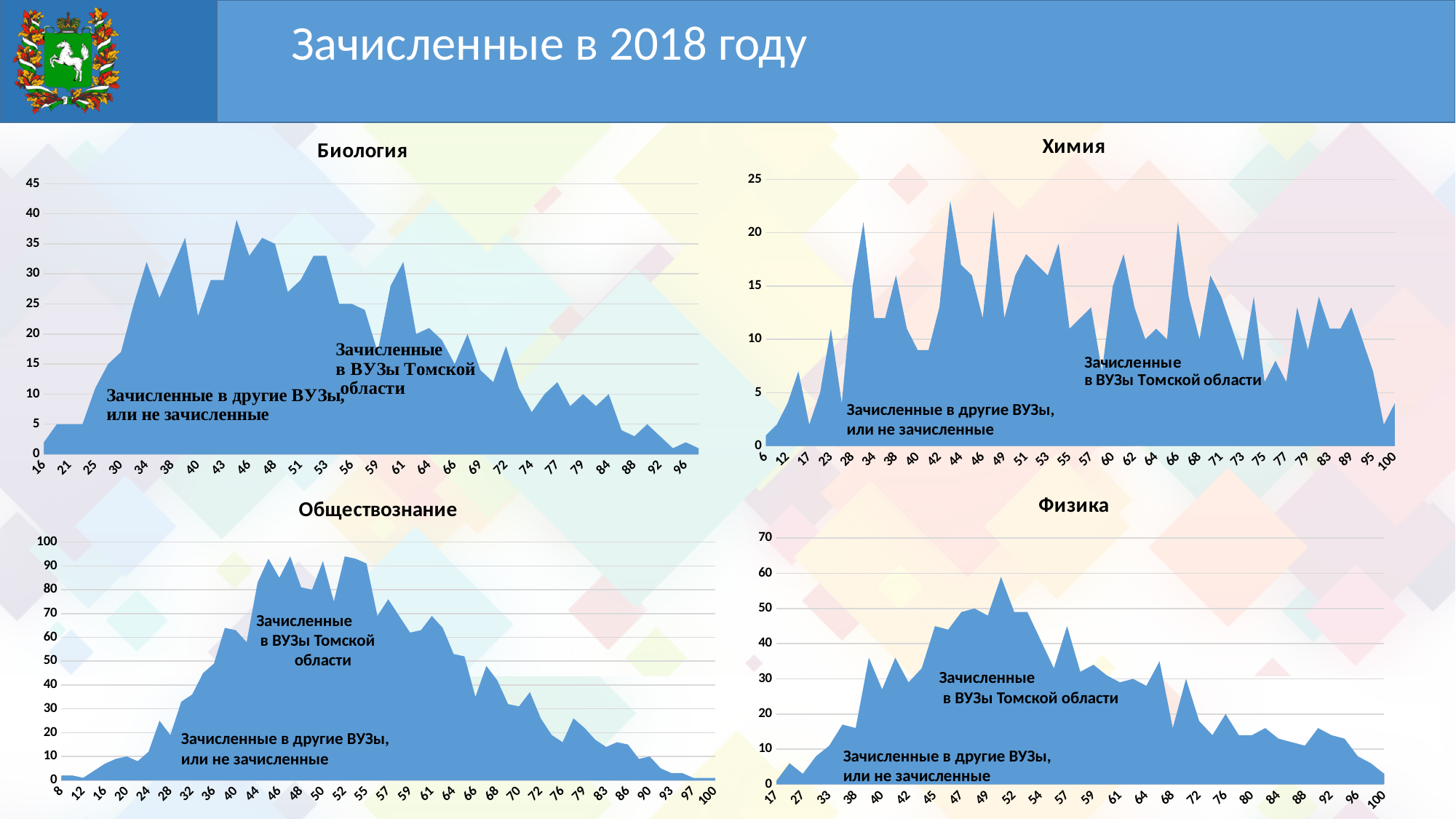
In the Обществознание chart, is the value at 46 greater or less than 80? greater In the Физика chart, do the values generally rise or fall from 68 to 100 along the x axis? fall In the Физика chart, is the value at 100 greater or less than 10? less What is the title of the chart in the top-right of the slide? Химия In the Биология chart, which is larger: the value at 46 or the value at 96? 46 What is the highest value shown on the y axis of the Обществознание chart? 100 How many charts are shown on the slide? 4 What kind of chart is the Биология chart? area chart